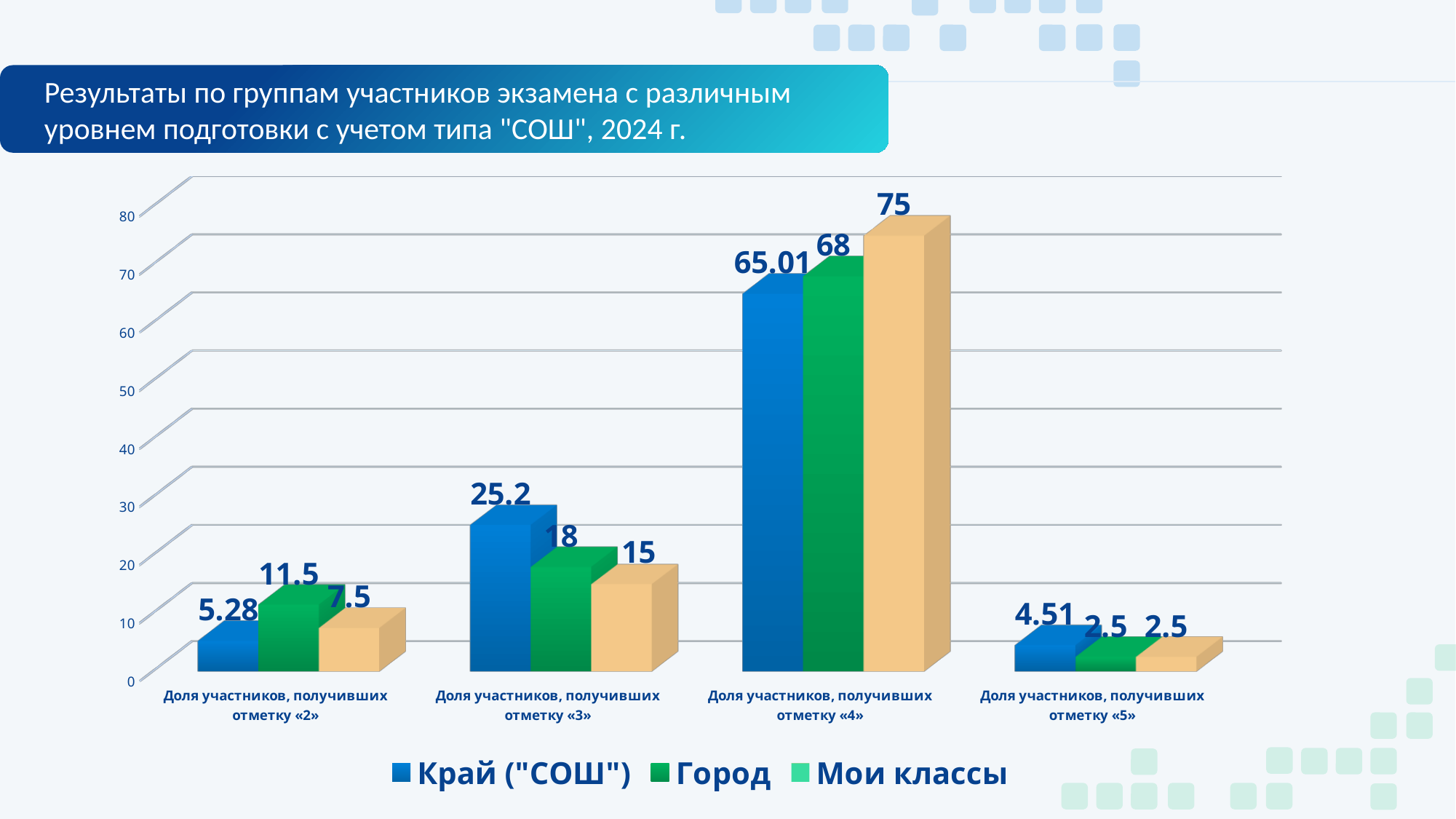
В какой категории серия «Мои классы» имеет наибольшее значение? Доля участников, получивших отметку «4» Сколько серий перечислено в легенде диаграммы? 3 Какого типа эта диаграмма? Столбчатая (bar chart) В какой категории серия «Край ("СОШ")» имеет наименьшее значение? Доля участников, получивших отметку «5» Какие серии перечислены в легенде диаграммы? Край ("СОШ"), Город, Мои классы Какое значение у серии «Край ("СОШ")» для категории «Доля участников, получивших отметку «4»»? 65.01 На сколько значение серии «Мои классы» больше значения серии «Город» в категории «Доля участников, получивших отметку «4»»? 7 Какое значение у серии «Мои классы» для категории «Доля участников, получивших отметку «3»»? 15 Сколько категорий показано на оси X диаграммы? 4 Какая серия имеет большее значение в категории «Доля участников, получивших отметку «3»»: «Край ("СОШ")» или «Город»? Край ("СОШ") Значение серии «Город» в категории «Доля участников, получивших отметку «4»» больше или меньше 60? больше Какое значение у серии «Город» для категории «Доля участников, получивших отметку «2»»? 11.5